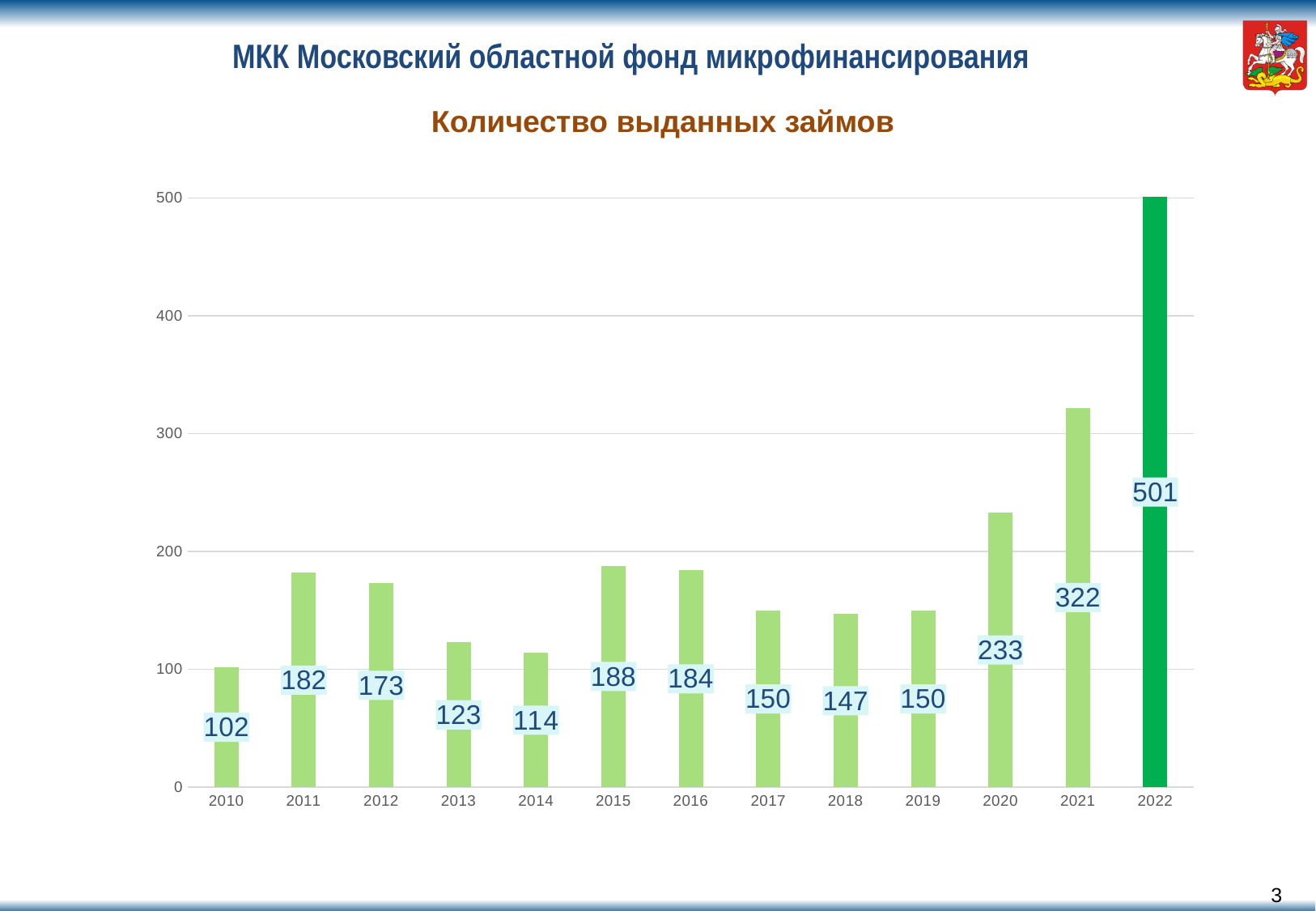
Which year has the lowest number of loans issued? 2010 Which is larger, the value for 2011 or the value for 2012? 2011 What kind of chart is shown on the slide? bar chart What is the difference between the values for 2015 and 2013? 65 What is the value shown for 2020? 233 Which year has the highest number of loans issued? 2022 What is the value shown for 2014? 114 What is the difference between the values for 2022 and 2021? 179 What is the title of the chart? Количество выданных займов What is the number of loans issued in 2022? 501 How many years are shown on the x axis? 13 Is the value for 2021 greater or less than 300? greater